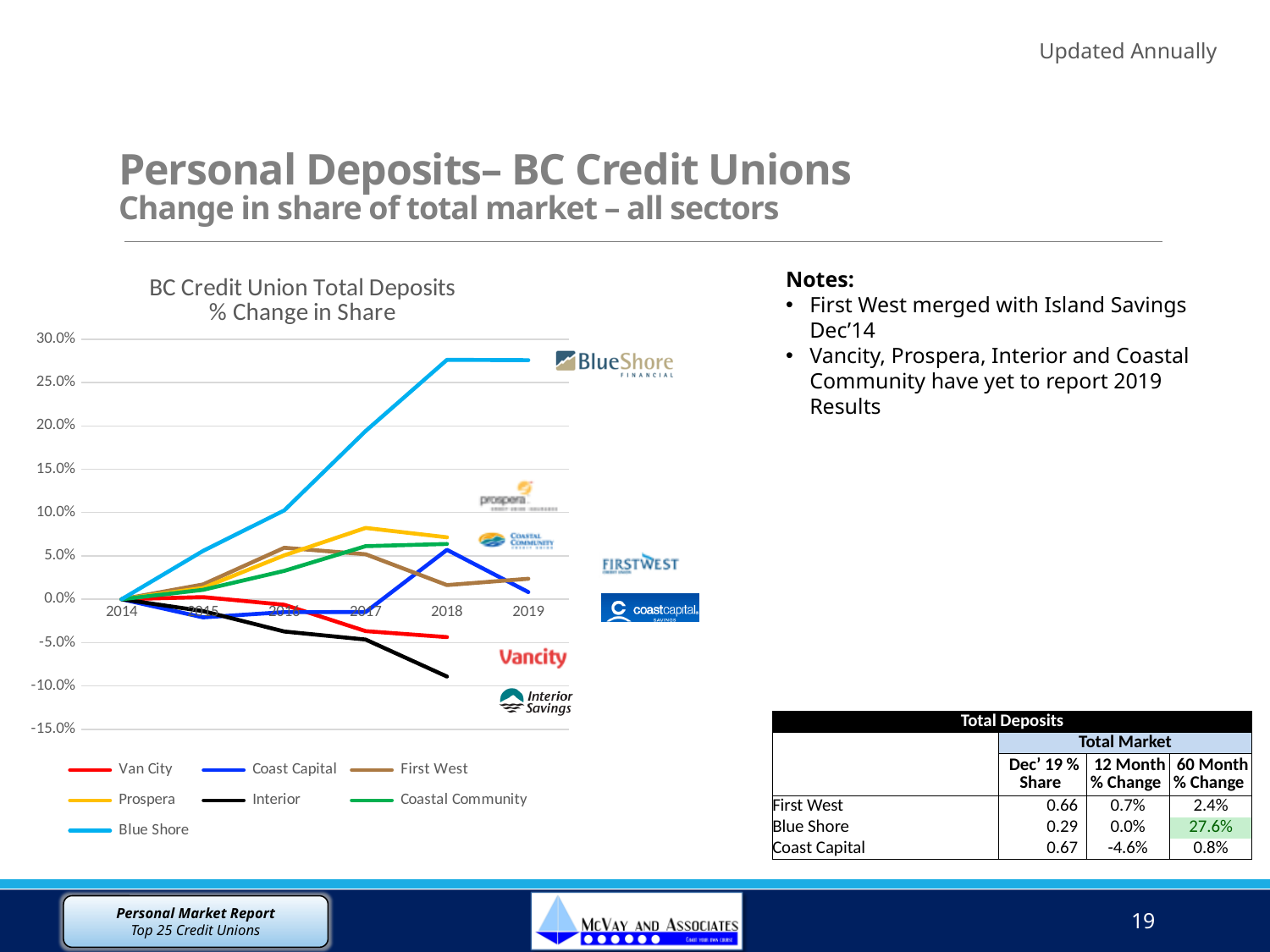
Which is larger in 2017, the value for Prospera or the value for Van City? Prospera Is the value for Interior in 2018 greater or less than -5.0%? less Which credit union has the lowest % change in share in 2018? Interior How many series does the chart legend list? 7 What kind of chart is shown on the slide? line chart How many years are shown along the x axis of the chart? 6 What is the title of the chart? BC Credit Union Total Deposits % Change in Share Is the value for Blue Shore in 2018 greater or less than 25.0%? greater Is the value for Blue Shore in 2016 greater or less than 5.0%? greater Does the Blue Shore line rise or fall from 2014 to 2018? rise Which credit union has the highest % change in share in 2018? Blue Shore